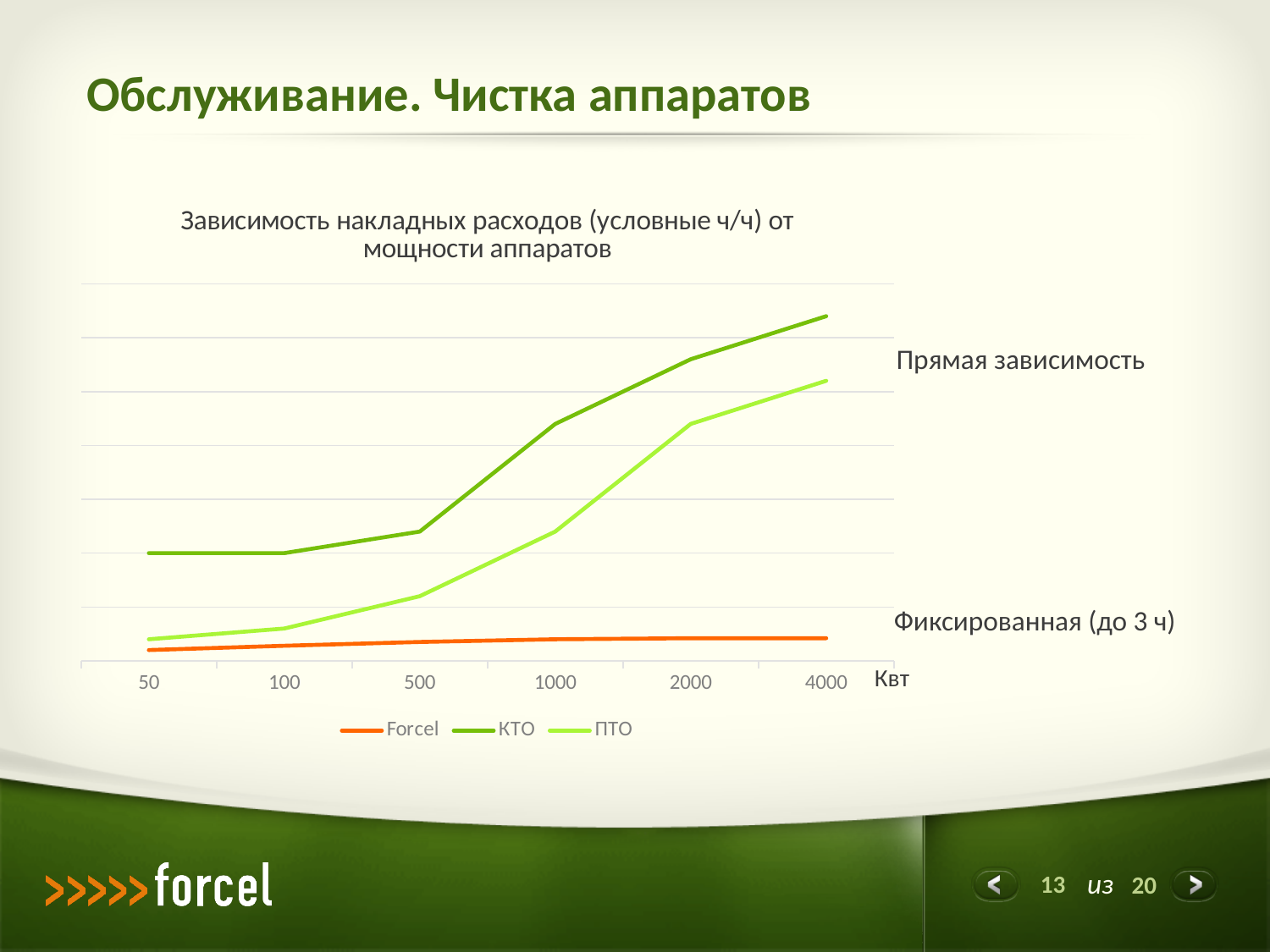
Which series are listed in the chart legend? Forcel, КТО, ПТО Which series stays nearly flat across the whole x axis? Forcel How many series does the chart legend list? 3 At 1000 Квт, which series is higher: КТО or ПТО? КТО What is the title of the chart? Зависимость накладных расходов (условные ч/ч) от мощности аппаратов Does the ПТО series rise or fall from 500 to 2000 Квт? rises How many points are plotted along the x axis for each series? 6 Which series has the lowest value at 4000 Квт? Forcel At 2000 Квт, which series is higher: ПТО or Forcel? ПТО Which series has the highest value at 4000 Квт? КТО Does the КТО series rise or fall as the power increases from 50 to 4000 Квт? rises What kind of chart is shown on the slide? line chart